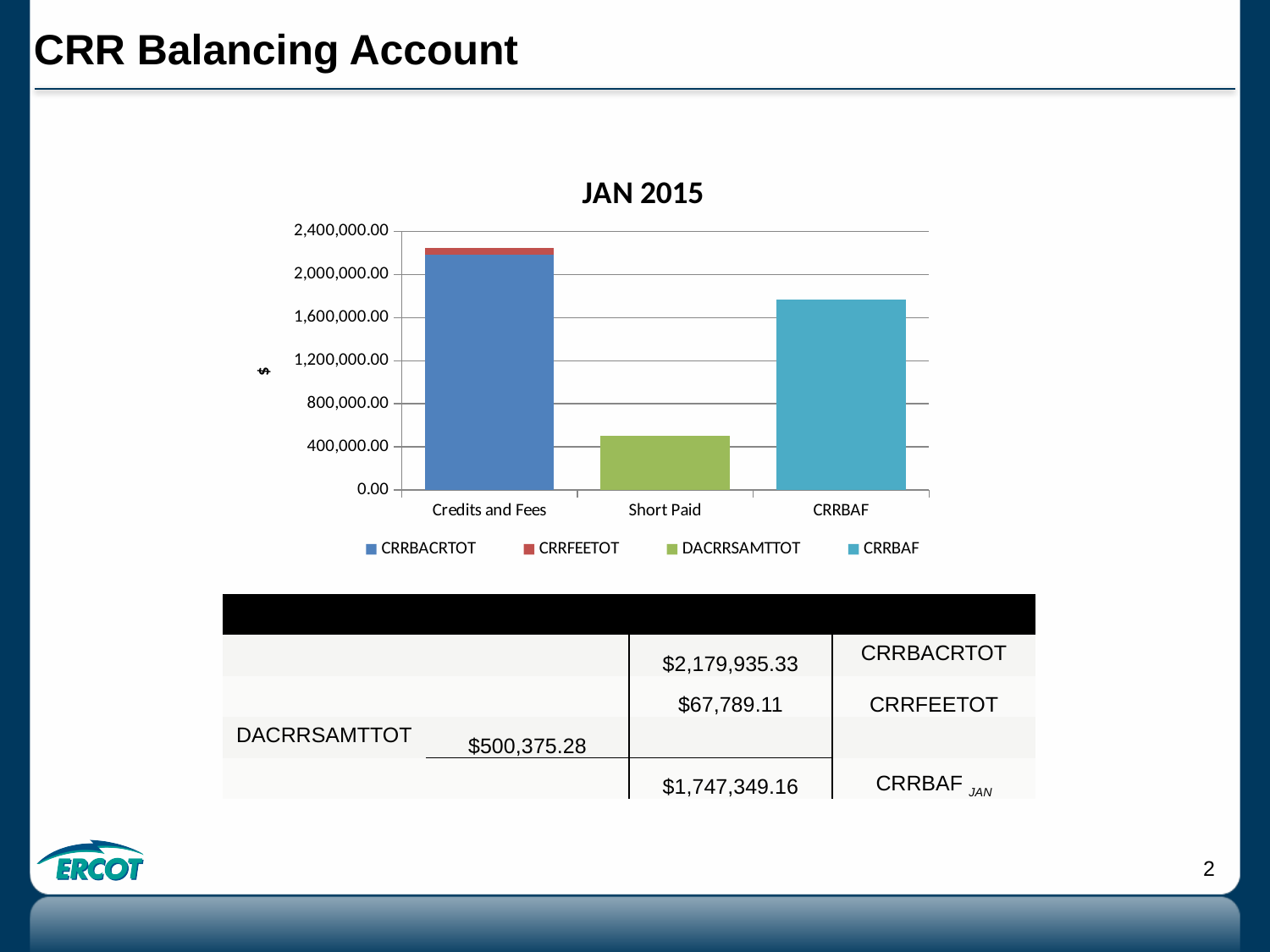
How many series does the chart legend list? 4 Is the value for Short Paid greater or less than 800,000.00? less Is the CRRBAF bar taller or shorter than the Credits and Fees bar? shorter What is the title of the chart? JAN 2015 Which category has the tallest bar in the chart? Credits and Fees Which category has the lowest bar in the chart? Short Paid How many categories are shown on the x axis of the chart? 3 According to the table on the slide, what is the value of CRRBACRTOT? $2,179,935.33 Is the value for CRRBAF greater or less than 1,600,000.00? greater According to the table on the slide, what is the value of DACRRSAMTTOT? $500,375.28 What type of chart is shown on the slide? bar chart What is the label on the vertical axis of the chart? $